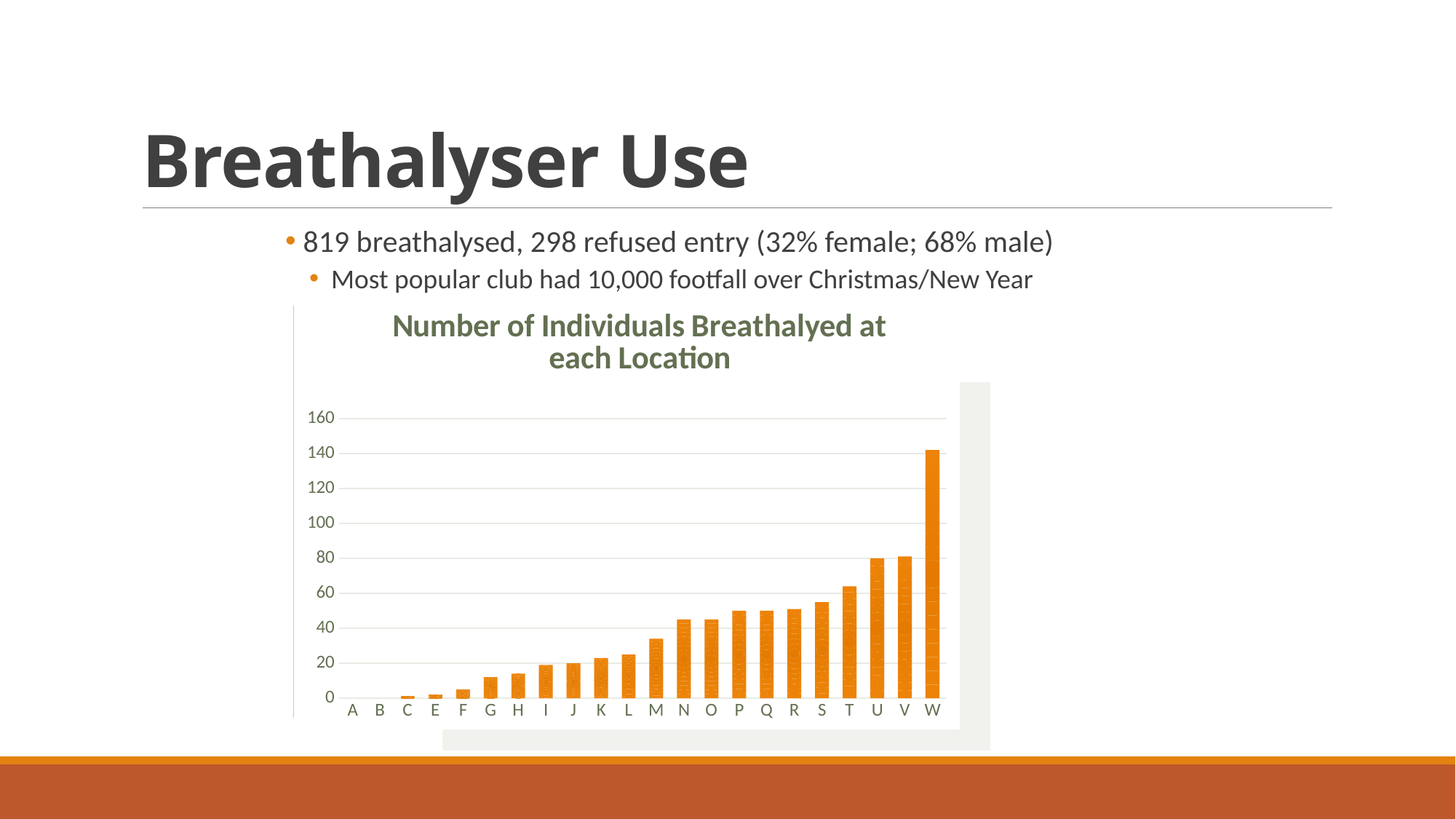
What kind of chart is shown on the slide? bar chart Is the value for location M greater or less than 40? less How many locations are shown on the x axis of the chart? 22 Do the values generally rise or fall moving from A to W along the x axis? rise Is the value for location W greater or less than 120? greater Is the value for location H greater or less than 20? less Which location has the larger value, T or M? T Which location has the larger value, W or V? W What is the title of the chart? Number of Individuals Breathalyed at each Location Which location has the highest number of individuals breathalysed? W